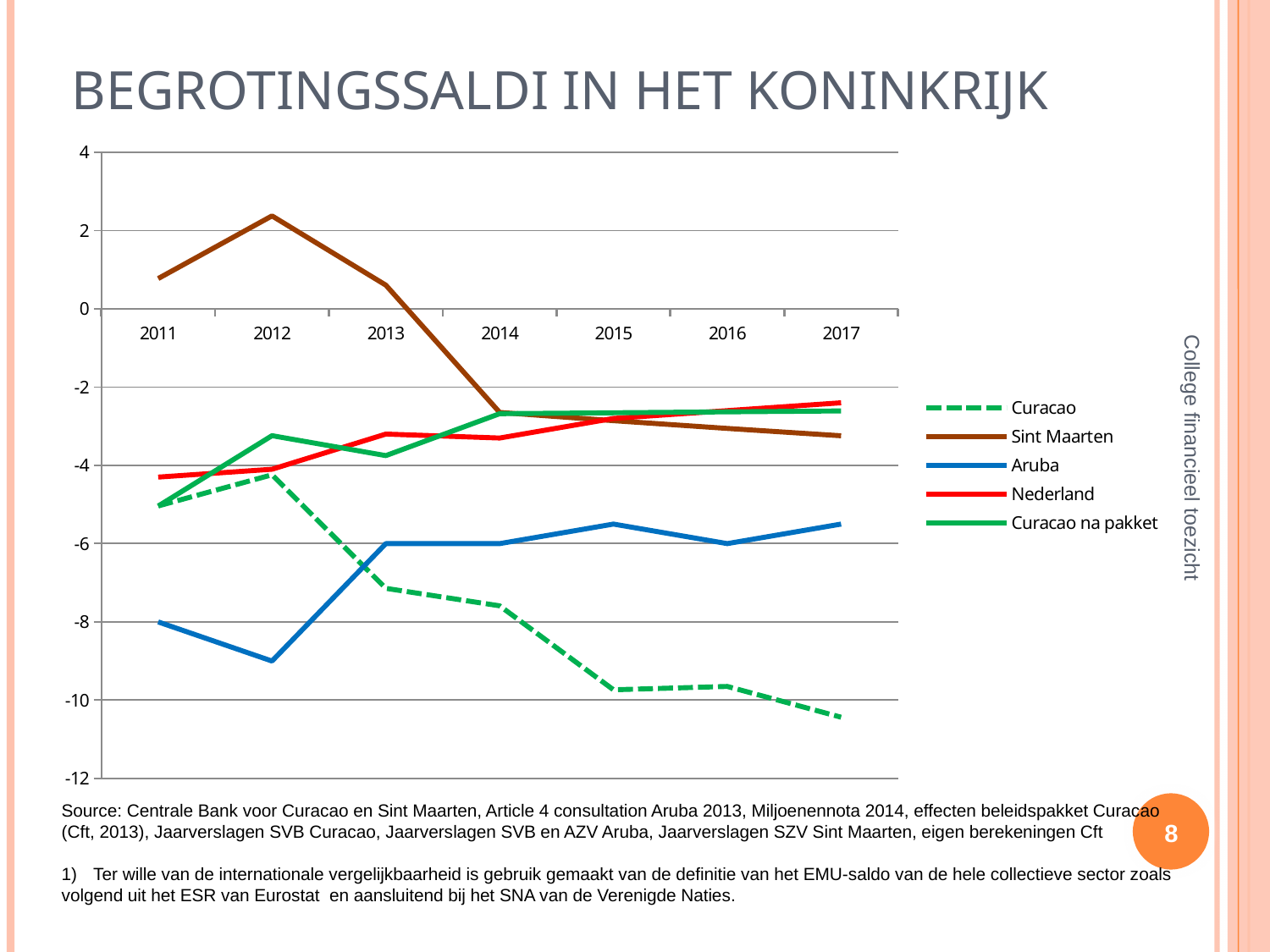
Is the value for Aruba in 2012 greater or less than -8? less In 2015, which is larger: the value for Aruba or the value for Curacao? Aruba Is the value for Curacao in 2017 greater or less than -10? less Which series has the lowest value in 2017? Curacao Is the value for Nederland in 2011 greater or less than -4? less What type of chart is shown on the slide? line chart How many series does the legend list? 5 How many years are shown on the x axis? 7 What is the value for Aruba in 2011? -8 Does the Curacao line rise or fall from 2013 to 2017? fall Which series has the highest value in 2012? Sint Maarten